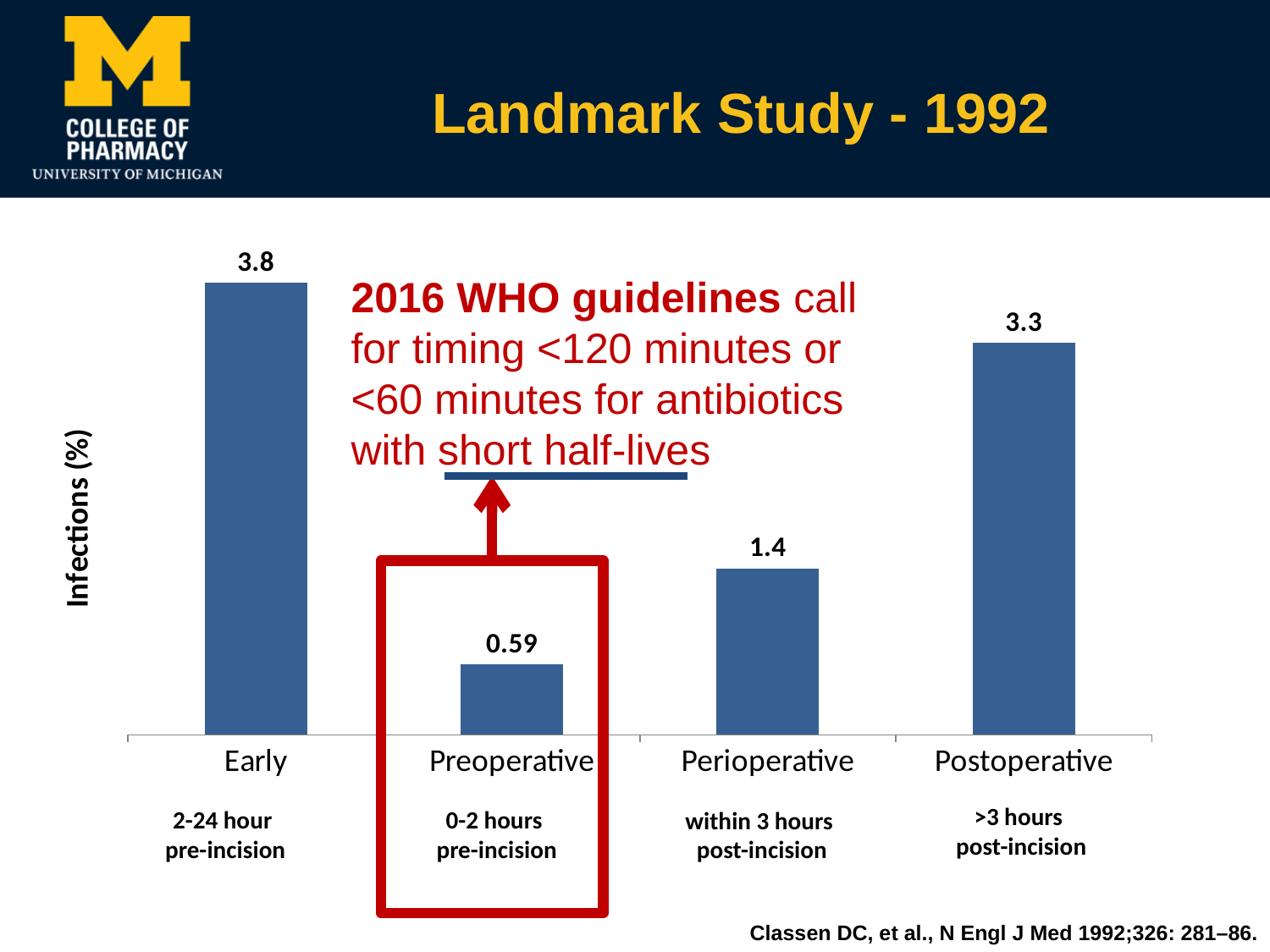
What is the infection rate (%) for the Postoperative category? 3.3 What is the difference in infection rate between the Postoperative and Perioperative categories? 1.9 What is the label of the y axis of the chart? Infections (%) Which has a higher infection rate, Perioperative or Postoperative? Postoperative What is the infection rate (%) for the Preoperative category? 0.59 How many categories are shown on the x axis of the chart? 4 What is the infection rate (%) for the Perioperative category? 1.4 What is the difference in infection rate between the Early and Preoperative categories? 3.21 What kind of chart is shown on the slide? Bar chart What is the infection rate (%) for the Early category? 3.8 Which category has the lowest infection rate? Preoperative Which category has the highest infection rate? Early